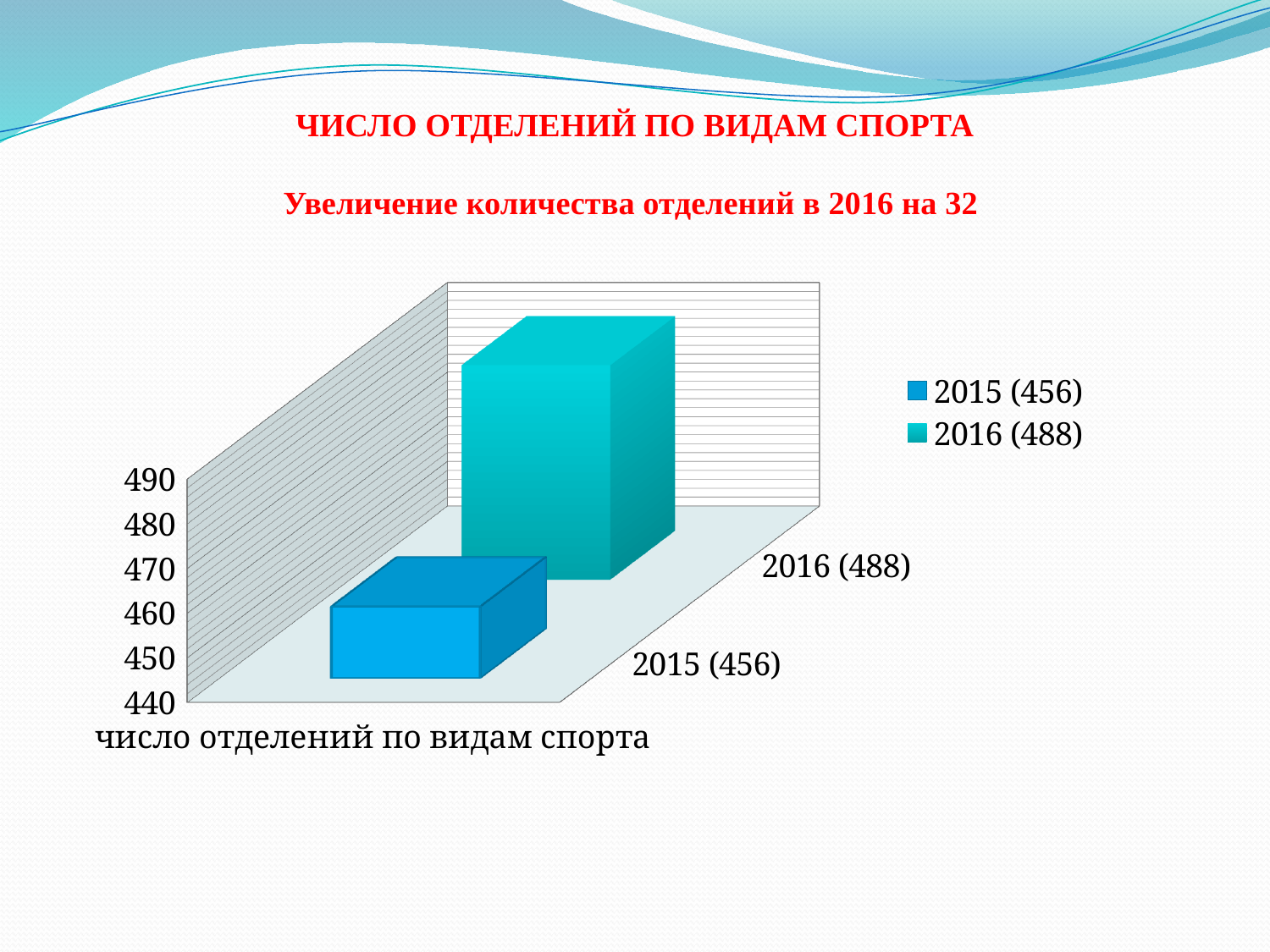
What is the number of sports departments for 2015? 456 Is the value for 2016 greater or less than 480? greater Which year has the higher number of sports departments? 2016 What is the title of the slide above the chart? ЧИСЛО ОТДЕЛЕНИЙ ПО ВИДАМ СПОРТА How many series does the legend list? 2 By how much did the number of departments increase from 2015 to 2016? 32 Is the value for 2015 greater or less than 460? less What is the number of sports departments for 2016? 488 What kind of chart is shown on the slide? bar chart Is the value for 2016 larger or smaller than the value for 2015? larger How many bars are plotted on the chart? 2 Which year has the lower number of sports departments? 2015